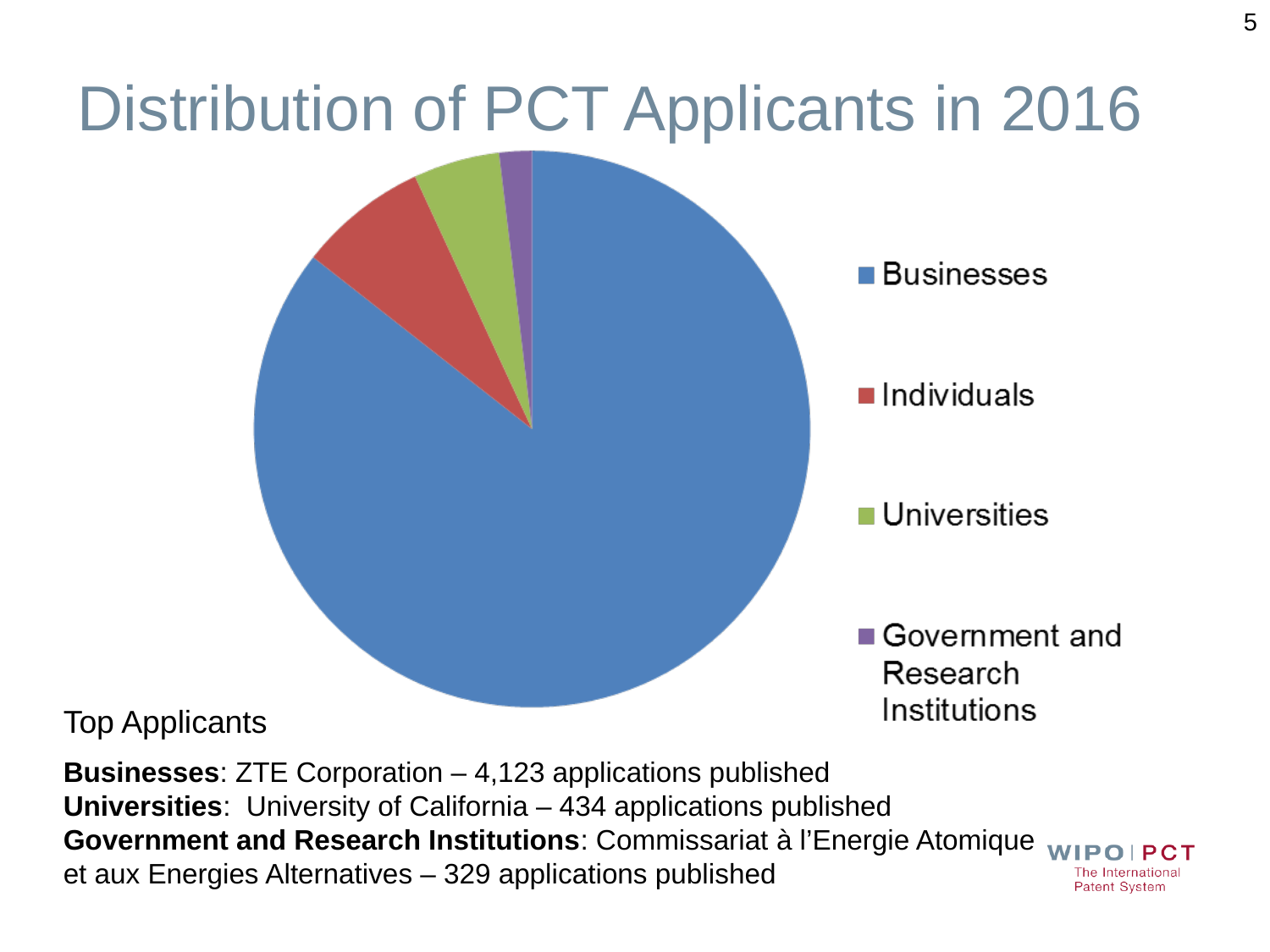
Which slice is larger, Businesses or Individuals? Businesses What is the title of the chart on the slide? Distribution of PCT Applicants in 2016 How many categories does the pie chart show? 4 Which slice is larger, Universities or Government and Research Institutions? Universities Which slice is larger, Individuals or Universities? Individuals How many entries does the legend list? 4 What kind of chart is shown on the slide? Pie chart Which category has the largest slice of the pie? Businesses Which category is shown in blue in the pie chart? Businesses Which category has the smallest slice of the pie? Government and Research Institutions